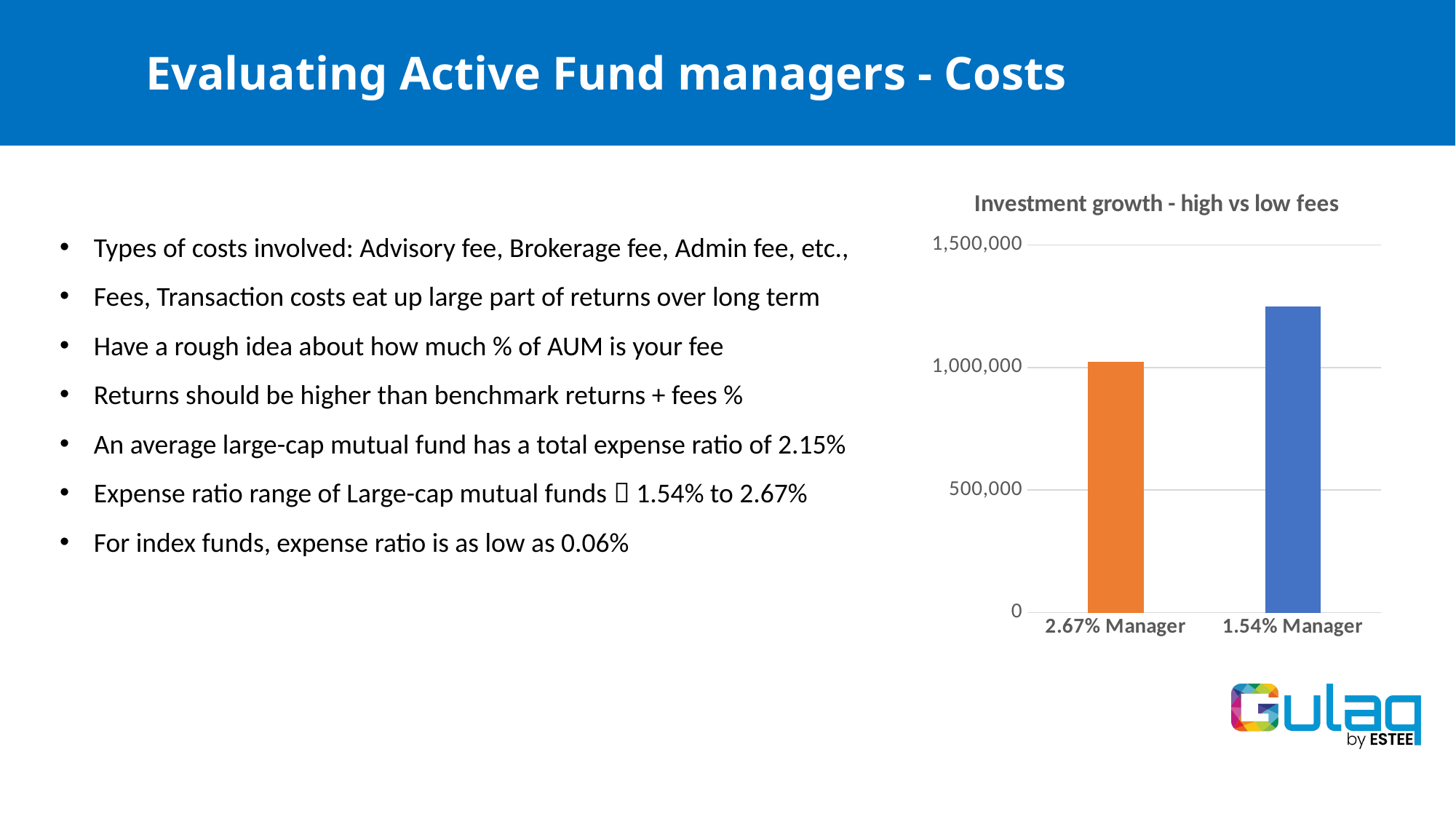
Do the bar values rise or fall moving from left to right along the x axis? rise Which manager has the lower investment growth in the chart? 2.67% Manager What kind of chart is shown on the slide? bar chart Is the bar for the 2.67% Manager or the 1.54% Manager taller? 1.54% Manager What is the highest value labelled on the vertical axis of the chart? 1,500,000 What is the title of the chart? Investment growth - high vs low fees Which manager has the higher investment growth in the chart? 1.54% Manager What colour is the bar for the 2.67% Manager? orange How many bars does the chart show? 2 Is the value for the 1.54% Manager greater or less than 1,500,000? less Is the value for the 1.54% Manager greater or less than 1,000,000? greater Is the value for the 2.67% Manager greater or less than 500,000? greater